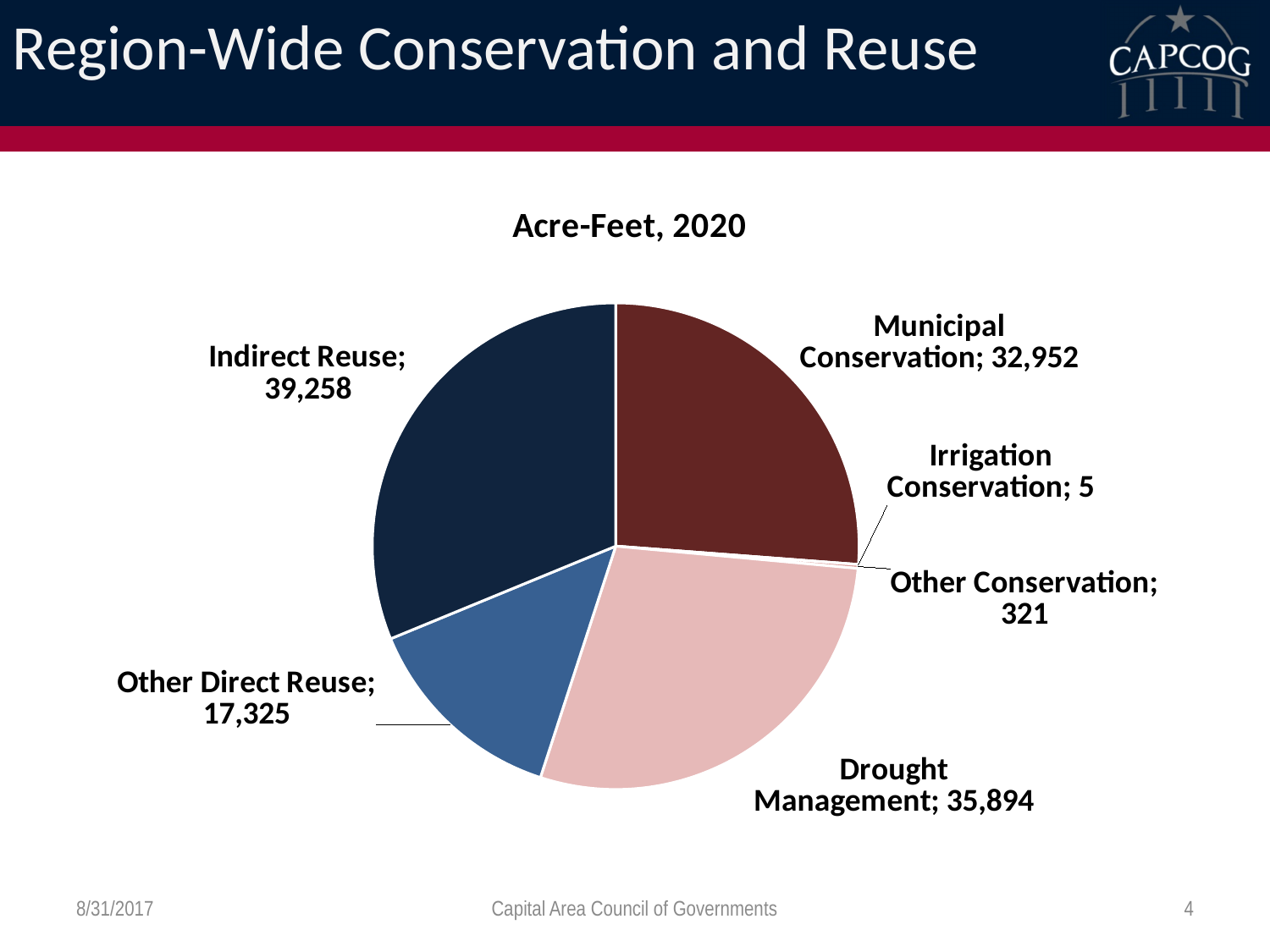
What is the title of the chart? Acre-Feet, 2020 What is the value for Indirect Reuse? 39,258 How many categories are shown in the pie chart? 6 Which category has the largest slice of the pie? Indirect Reuse What is the value for Drought Management? 35,894 What is the difference between Municipal Conservation and Other Direct Reuse? 15,627 What is the difference between Indirect Reuse and Drought Management? 3,364 Which category has the smallest value? Irrigation Conservation Which is larger, Drought Management or Municipal Conservation? Drought Management What is the value for Irrigation Conservation? 5 What kind of chart is shown on the slide? Pie chart What is the value for Other Direct Reuse? 17,325